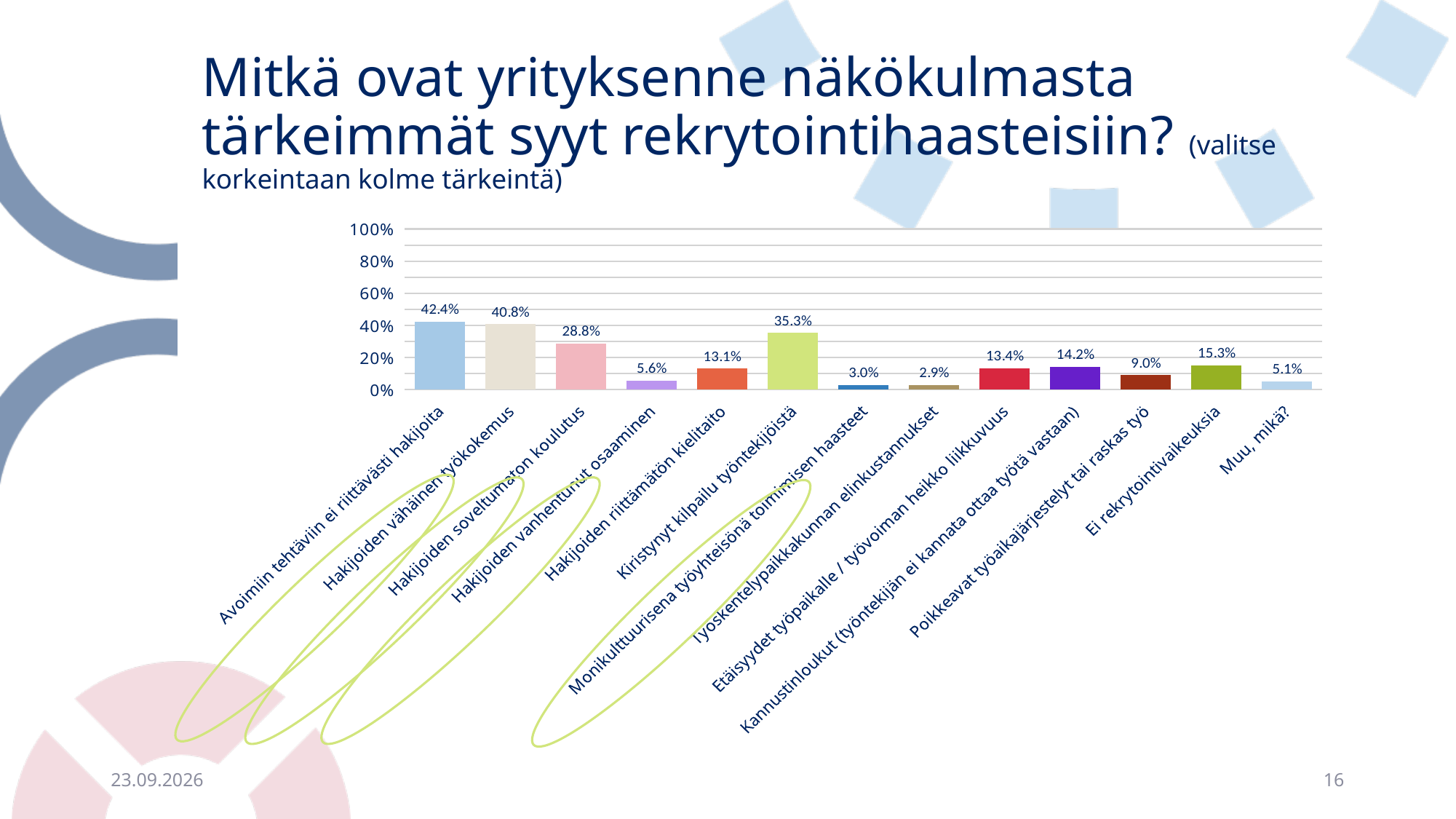
Which is larger, the value for "Hakijoiden soveltumaton koulutus" or the value for "Kiristynyt kilpailu työntekijöistä"? Kiristynyt kilpailu työntekijöistä What kind of chart is shown on the slide? Bar chart Which category has the highest value? Avoimiin tehtäviin ei riittävästi hakijoita How many categories are shown in the chart? 13 What is the value for "Kiristynyt kilpailu työntekijöistä"? 35.3% Which category has the lowest value? Työskentelypaikkakunnan elinkustannukset What is the highest value shown on the vertical axis? 100% Is the value for "Hakijoiden vähäinen työkokemus" greater or less than 20%? greater What is the value for "Avoimiin tehtäviin ei riittävästi hakijoita"? 42.4% What is the value for "Ei rekrytointivaikeuksia"? 15.3% What is the difference between the values for "Avoimiin tehtäviin ei riittävästi hakijoita" and "Hakijoiden vähäinen työkokemus"? 1.6% What is the value for "Muu, mikä?"? 5.1%